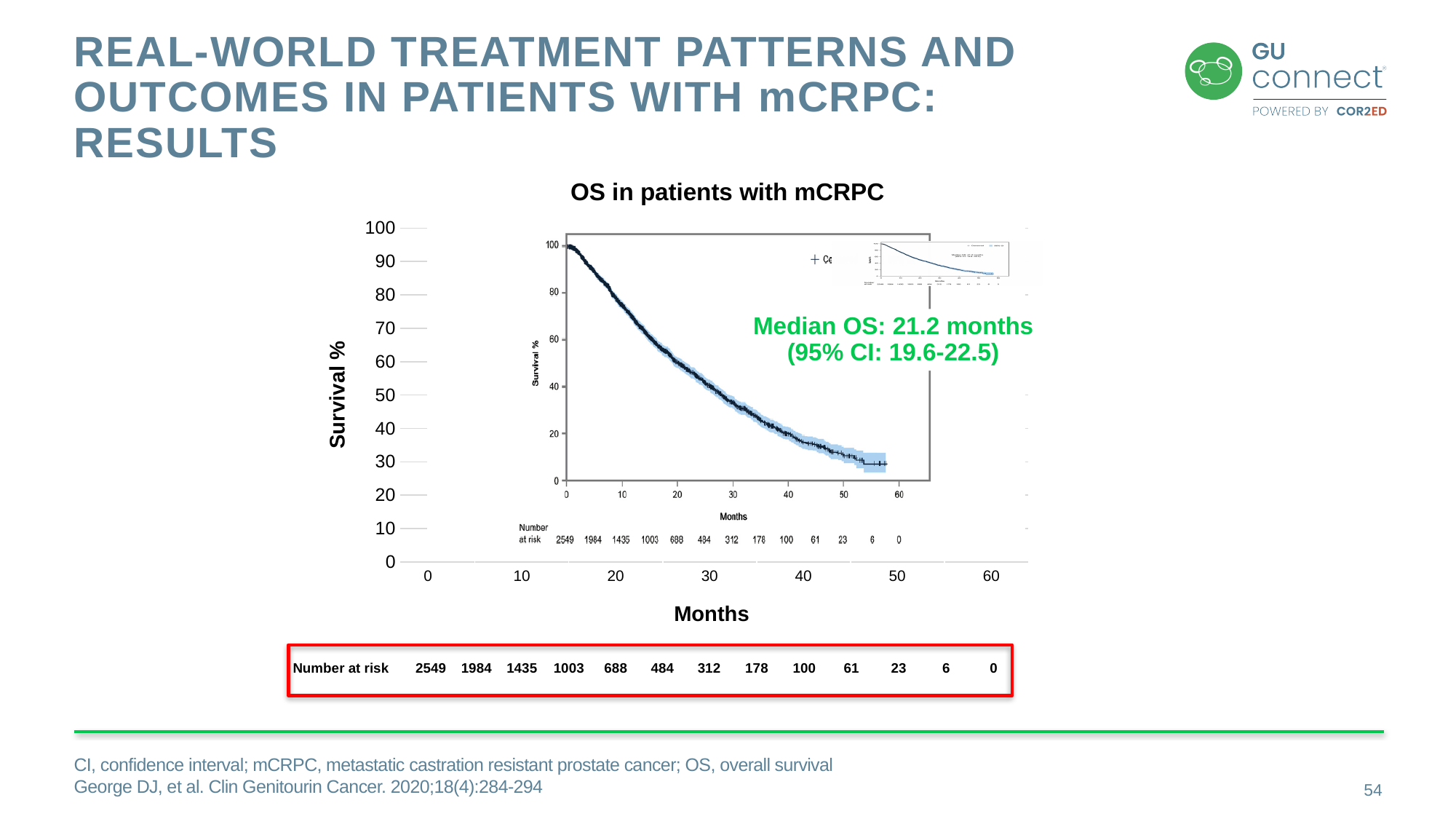
What is the 95% confidence interval for the median OS shown on the chart? 19.6-22.5 Does the survival curve rise or fall as months increase? fall Is the survival % at 30 months greater or less than 40? less What is the median OS reported on the chart? 21.2 months Which has a larger number at risk: 10 months or 20 months? 10 months What kind of chart is shown on the slide? line chart What is the difference between the number at risk at 0 months (2549) and at 5 months (1984)? 565 How many number-at-risk values are listed in the table below the chart? 13 What is the number at risk at 30 months? 312 What is the title of the chart? OS in patients with mCRPC What is the number at risk at 60 months? 0 What is the number at risk at 0 months? 2549